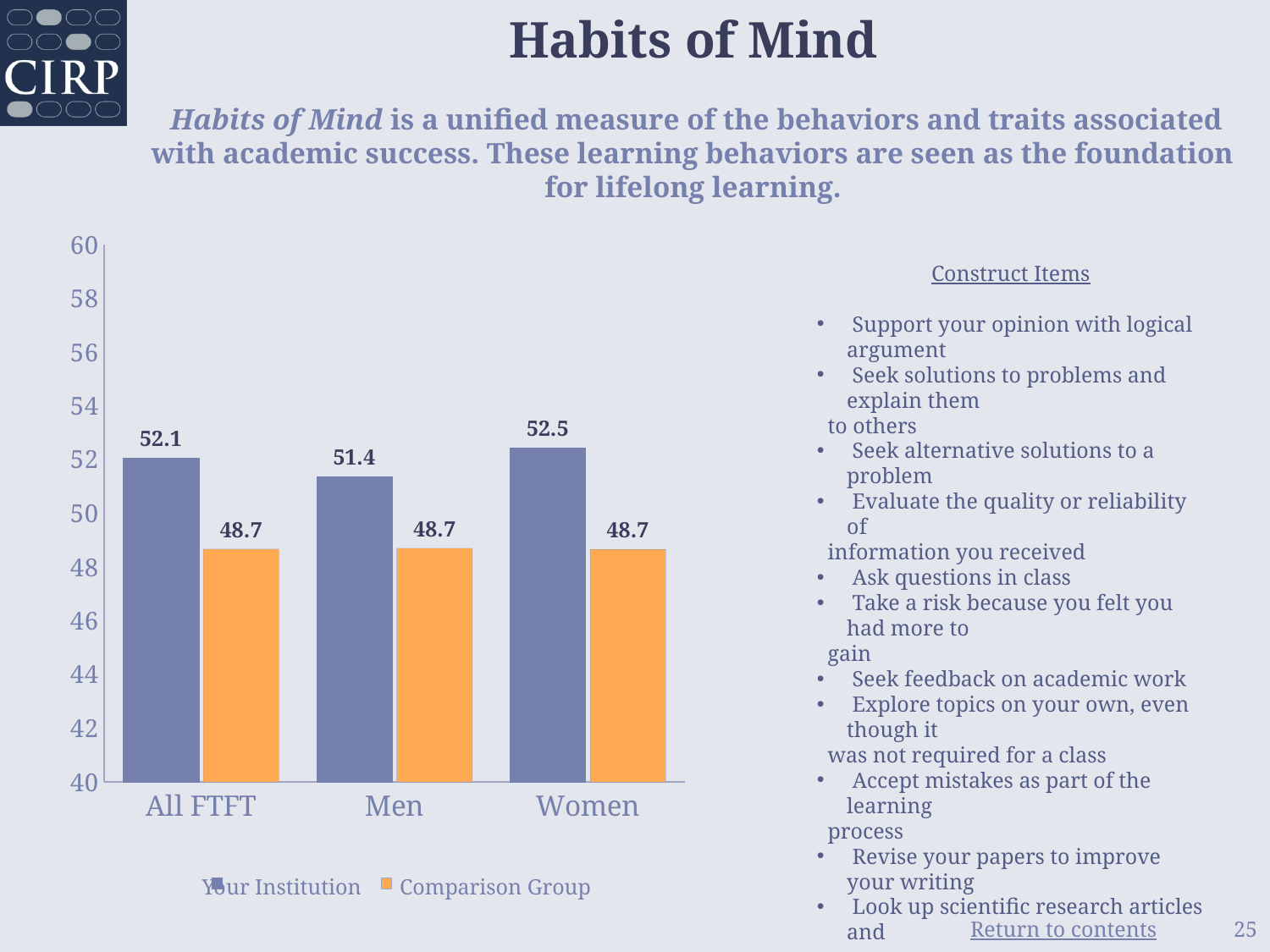
For Men, which is larger: Your Institution or Comparison Group? Your Institution How many series does the legend list? 2 What is the difference between the Your Institution and Comparison Group values for Women? 3.8 What is the Comparison Group value for Women? 48.7 How many categories are shown on the x axis? 3 What kind of chart is shown on the slide? bar chart What is the Your Institution value for Men? 51.4 Is the Your Institution value for Women greater or less than 50? greater Which category has the lowest Your Institution value? Men What is the difference between the Your Institution values for All FTFT and Men? 0.7 What is the Your Institution value for All FTFT? 52.1 Which category has the highest Your Institution value? Women